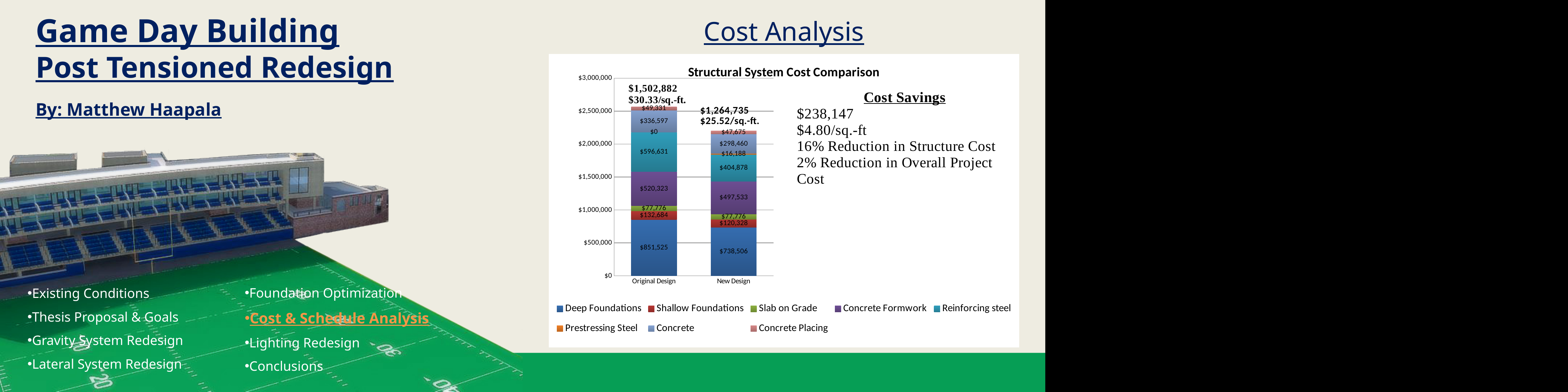
What is the Reinforcing steel cost for the New Design? $404,878 What is the Prestressing Steel cost for the Original Design? $0 How many series does the chart legend list? 8 Which cost component is the largest segment in the New Design bar? Deep Foundations What is the title of the chart? Structural System Cost Comparison How many design categories are plotted on the x axis of the chart? 2 What type of chart is shown on the slide? Stacked bar chart What is the difference in Deep Foundations cost between the Original Design and the New Design? $113,019 What is the Deep Foundations cost for the Original Design? $851,525 What is the Concrete Placing cost for the Original Design? $49,331 Which design has the higher Concrete Formwork cost, Original Design or New Design? Original Design Is the total height of the New Design bar greater or less than $2,000,000? greater